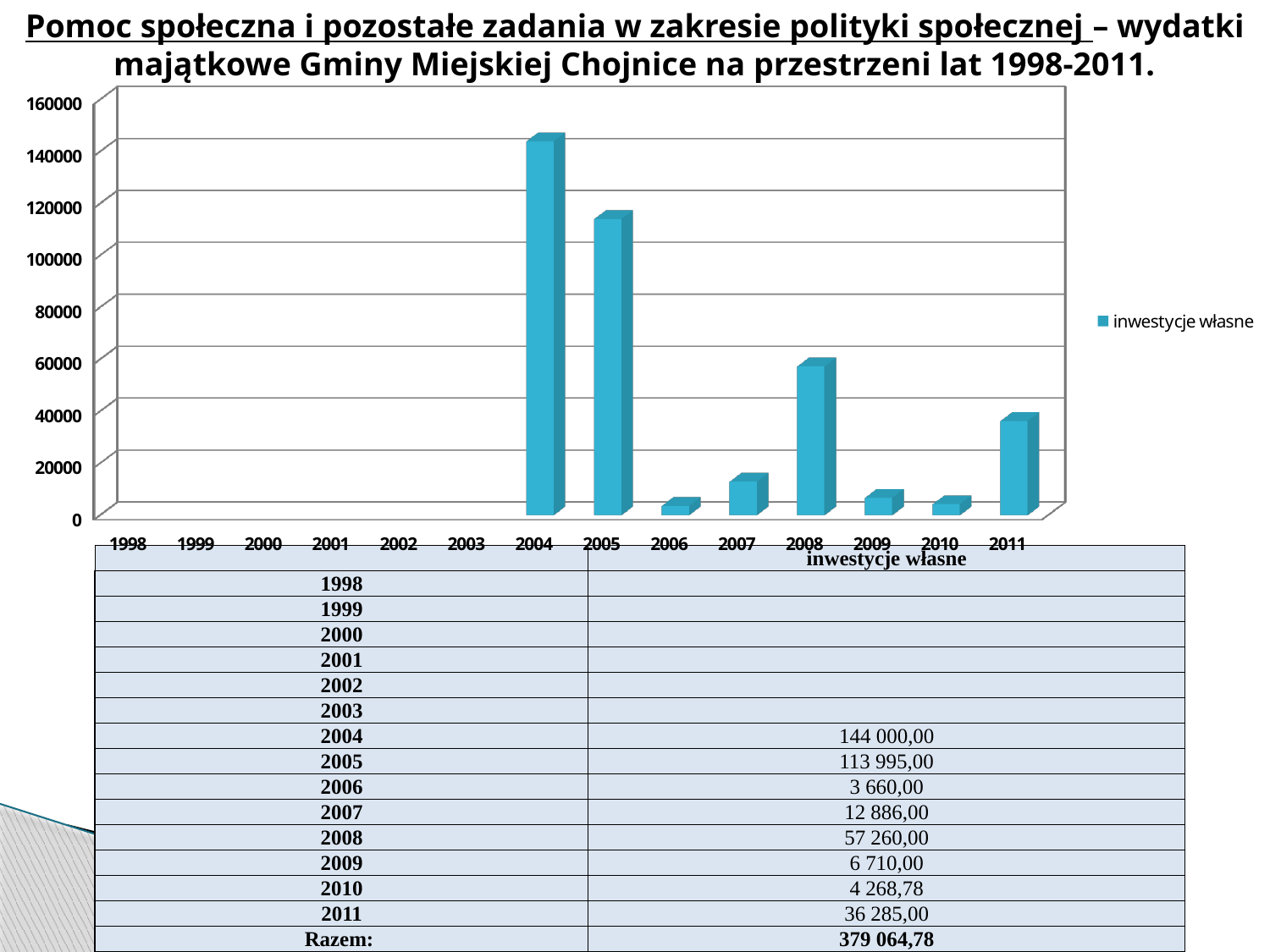
What is the value for inwestycje własne in 2004? 144 000,00 What is the value for inwestycje własne in 2011? 36 285,00 Is the value for 2007 greater or less than 20000? less What is the name of the series shown in the chart legend? inwestycje własne How many series does the chart legend list? 1 Is the value for 2005 greater or less than 100000? greater What kind of chart is shown on the slide? bar chart Which year has the highest value for inwestycje własne? 2004 What is the difference between the values for 2004 and 2005? 30 005,00 Which is larger, the value for 2008 or the value for 2011? 2008 What is the value for inwestycje własne in 2008? 57 260,00 How many years are shown on the x axis of the chart? 14